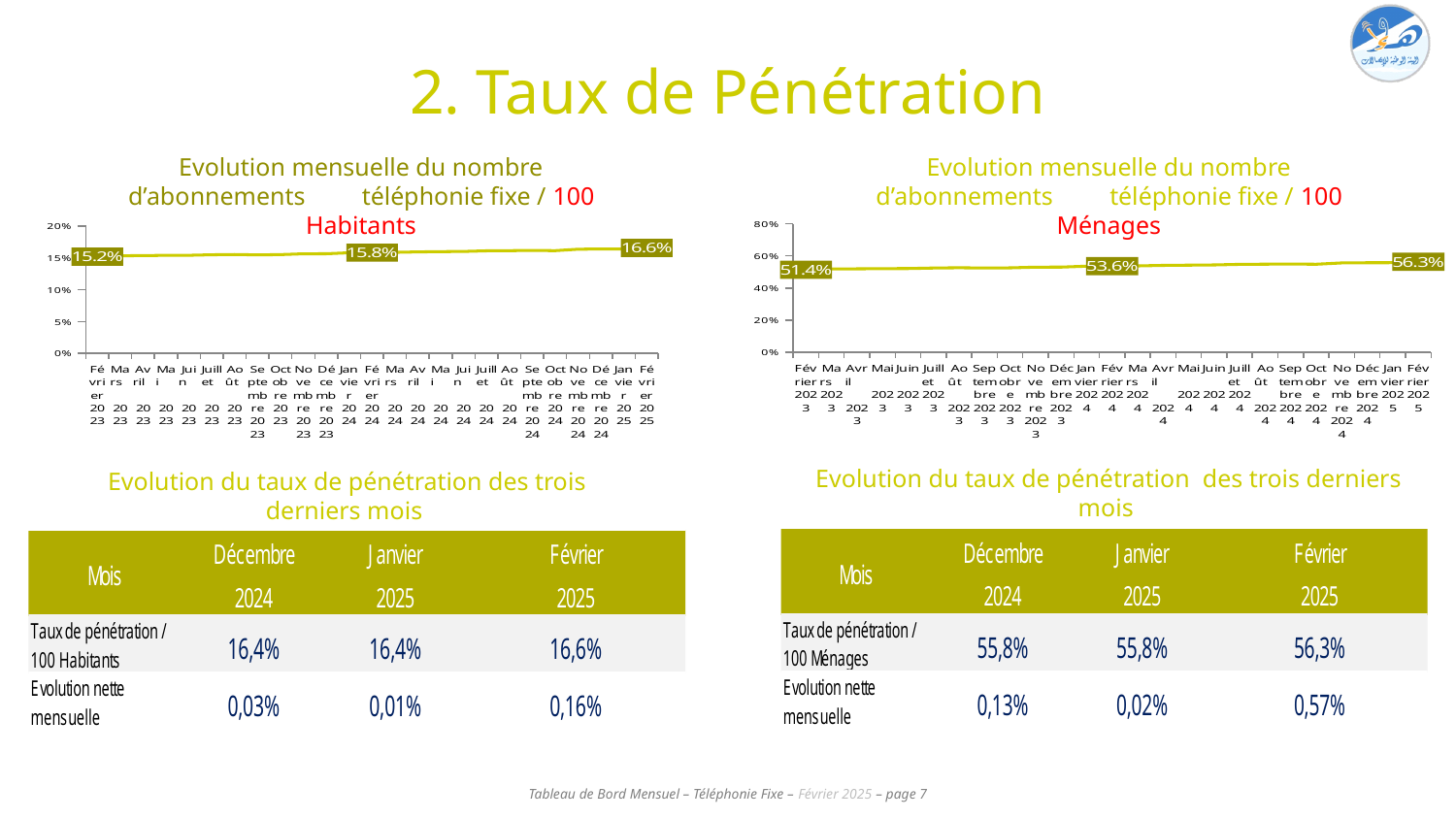
What kind of chart is the left chart, 'Evolution mensuelle du nombre d'abonnements téléphonie fixe / 100 Habitants'? line chart In the left chart (/ 100 Habitants), what is the difference between the labelled values for Février 2025 and Février 2023? 1.4 percentage points In the right chart (/ 100 Ménages), what value is labelled at the first point, Février 2023? 51.4% In the right chart (/ 100 Ménages), what is the difference between the labelled values for Février 2025 and Février 2023? 4.9 percentage points In the left chart (/ 100 Habitants), what value is labelled at the middle point, Février 2024? 15.8% In the right chart (/ 100 Ménages), do the values rise or fall from Février 2023 to Février 2025? rise In the left chart (/ 100 Habitants), what value is labelled at the first point, Février 2023? 15.2% In the right chart (/ 100 Ménages), what value is labelled at the middle point, Février 2024? 53.6% In the left chart (/ 100 Habitants), what value is labelled at the last point, Février 2025? 16.6% In the right chart (/ 100 Ménages), is the value for Février 2025 greater or less than 60%? less In the left chart (/ 100 Habitants), which labelled point has the highest value? Février 2025 In the right chart (/ 100 Ménages), what value is labelled at the last point, Février 2025? 56.3%